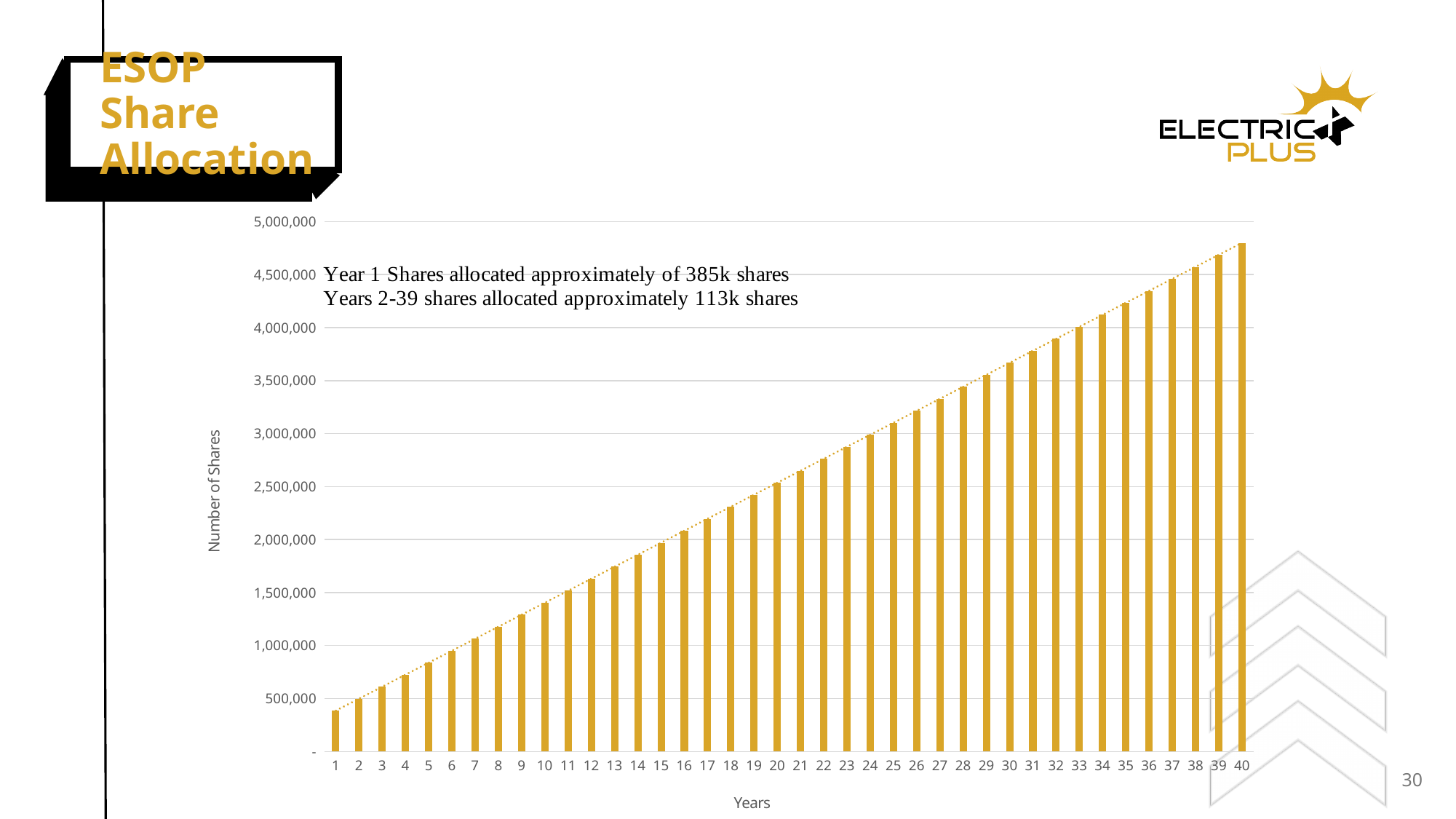
Is the value for year 1 greater or less than 500,000? less Is the value for year 30 greater or less than 3,500,000? greater Which is larger, the value for year 20 or the value for year 30? year 30 Do the values rise or fall as the years increase along the x axis? rise How many years (bars) are plotted on the x axis? 40 Is the value for year 40 greater or less than 4,500,000? greater What kind of chart is shown on the slide? bar chart Which year has the lowest number of shares? 1 What is the title of the vertical axis? Number of Shares Which year has the highest number of shares? 40